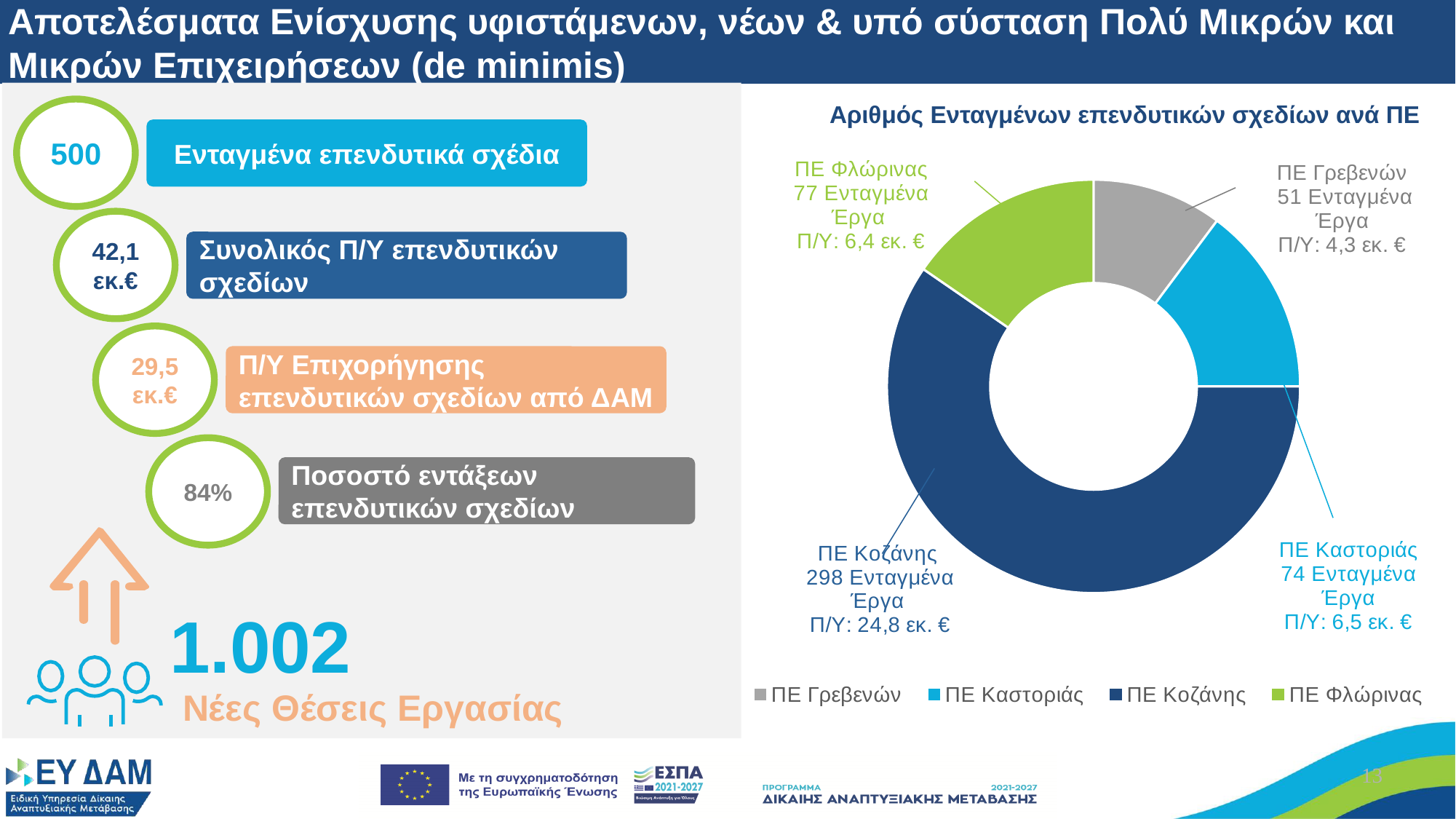
How many Ενταγμένα Έργα does the chart show for ΠΕ Γρεβενών? 51 How many entries does the chart legend list? 4 What is the difference in Ενταγμένα Έργα between ΠΕ Κοζάνης and ΠΕ Καστοριάς? 224 What is the title of the chart on the right of the slide? Αριθμός Ενταγμένων επενδυτικών σχεδίων ανά ΠΕ How many Ενταγμένα Έργα does the chart show for ΠΕ Κοζάνης? 298 How many ΠΕ categories does the chart show? 4 What is the Π/Υ shown for ΠΕ Καστοριάς in the chart? 6,5 εκ. € Which ΠΕ has the lowest number of Ενταγμένα Έργα in the chart? ΠΕ Γρεβενών What kind of chart is shown on the right of the slide? doughnut (pie) chart Which has more Ενταγμένα Έργα, ΠΕ Φλώρινας or ΠΕ Καστοριάς? ΠΕ Φλώρινας What is the Π/Υ shown for ΠΕ Φλώρινας in the chart? 6,4 εκ. € Which ΠΕ has the highest number of Ενταγμένα Έργα in the chart? ΠΕ Κοζάνης